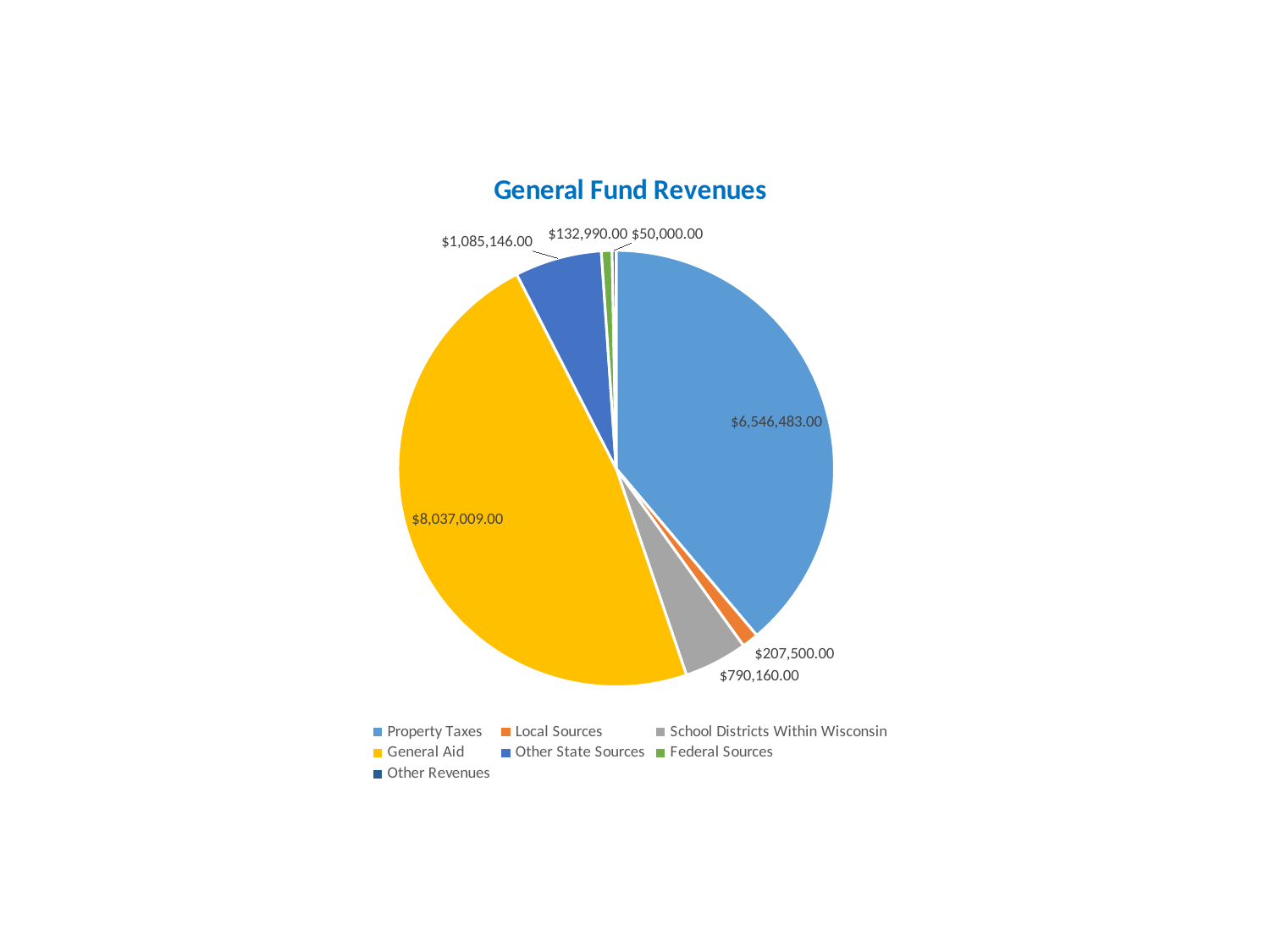
What is the value for Other State Sources in the General Fund Revenues pie chart? $1,085,146.00 What is the value for Property Taxes in the General Fund Revenues pie chart? $6,546,483.00 What is the title of the chart on the slide? General Fund Revenues What is the value for General Aid in the General Fund Revenues pie chart? $8,037,009.00 How many categories are shown in the General Fund Revenues pie chart? 7 What kind of chart is used to show General Fund Revenues? Pie chart What is the difference between General Aid and Property Taxes in the General Fund Revenues pie chart? $1,490,526.00 Which is larger in the General Fund Revenues pie chart, Other State Sources or School Districts Within Wisconsin? Other State Sources Which category has the largest slice in the General Fund Revenues pie chart? General Aid What is the value for Local Sources in the General Fund Revenues pie chart? $207,500.00 What is the value for Federal Sources in the General Fund Revenues pie chart? $132,990.00 Which category has the smallest slice in the General Fund Revenues pie chart? Other Revenues